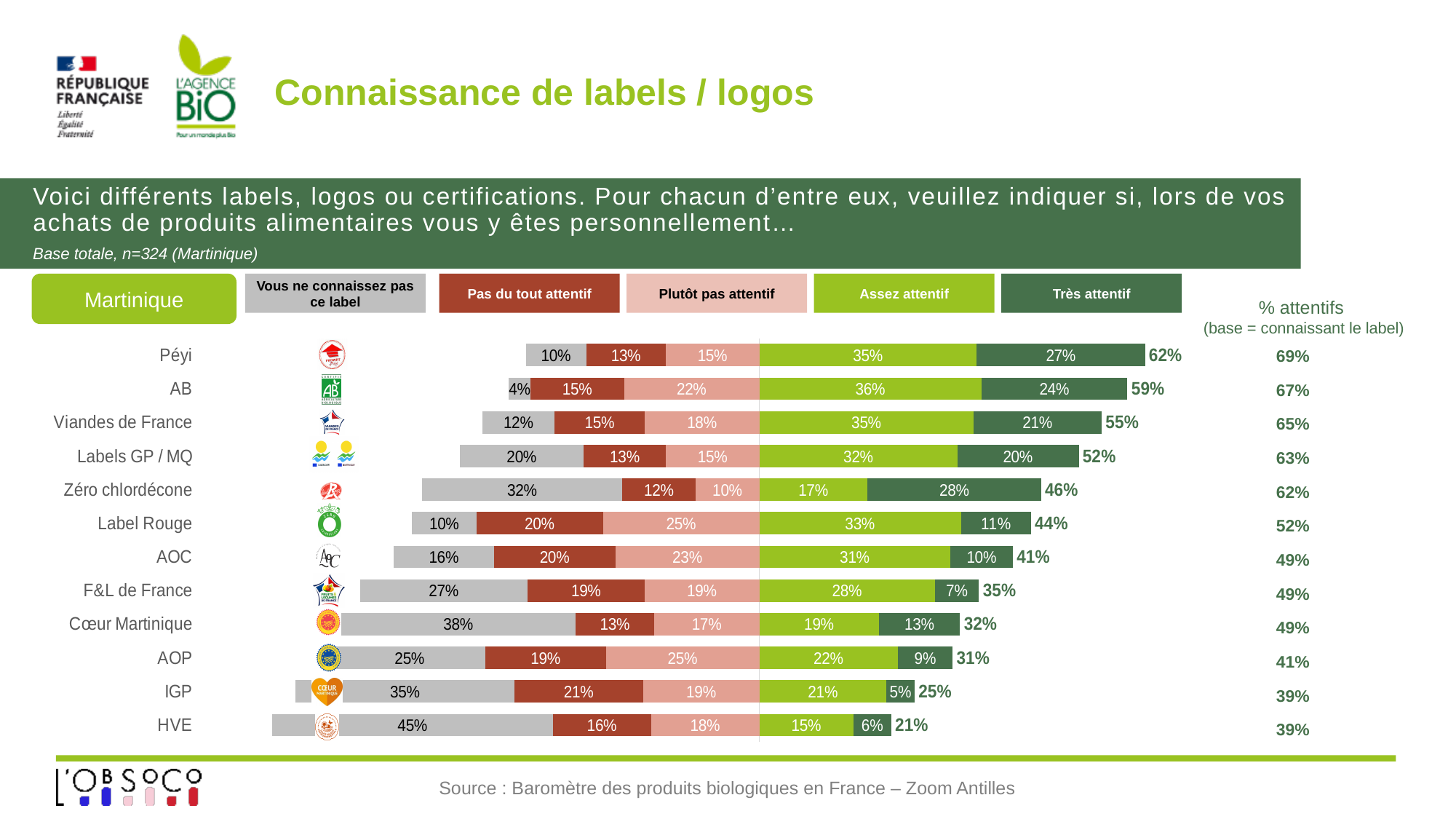
What kind of chart is shown on the slide? Stacked bar chart What is the difference between the 'Assez attentif' and 'Très attentif' values for Péyi? 8 points What is the 'Très attentif' value for Péyi? 27% What is the 'Assez attentif' value for AB? 36% What percentage of respondents do not know the HVE label ('Vous ne connaissez pas ce label')? 45% How many labels/logos are listed as categories in the chart? 12 What is the '% attentifs' value shown for Zéro chlordécone? 62% Which label has the highest '% attentifs' value in the right-hand column? Péyi How many response categories does the legend list? 5 Which has a larger 'Vous ne connaissez pas ce label' share: Cœur Martinique or IGP? Cœur Martinique Which label has the lowest combined attentive share (bold value at the end of the bar)? HVE Which label has the highest share of respondents who do not know it ('Vous ne connaissez pas ce label')? HVE